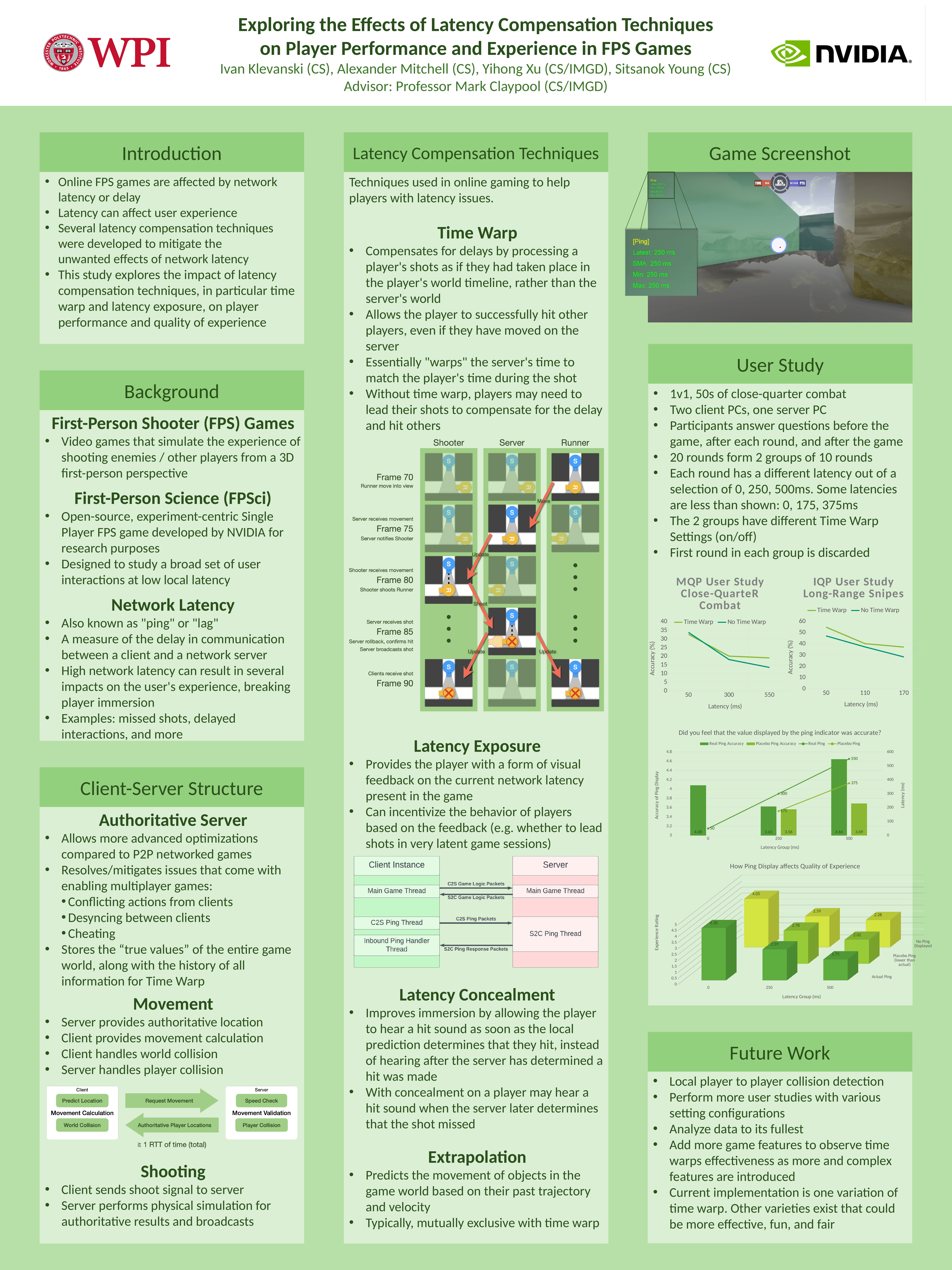
In the 'MQP User Study Close-QuarteR Combat' chart, does accuracy rise or fall as latency increases? fall In the 'IQP User Study Long-Range Snipes' chart, which series has the higher accuracy at 170 ms latency, Time Warp or No Time Warp? Time Warp In the 'MQP User Study Close-QuarteR Combat' chart, is the No Time Warp accuracy at 550 ms latency greater or less than 15? less In the 'MQP User Study Close-QuarteR Combat' chart, how many series does the legend list? 2 In the 'IQP User Study Long-Range Snipes' chart, how many latency values are plotted on the x axis? 3 In the chart titled 'Did you feel that the value displayed by the ping indicator was accurate?', which latency group has the highest Real Ping Accuracy bar? 500 In the 'MQP User Study Close-QuarteR Combat' chart, what are the two legend entries? Time Warp and No Time Warp In the chart titled 'Did you feel that the value displayed by the ping indicator was accurate?', what is the difference between the Real Ping Accuracy and Placebo Ping Accuracy for the 500 ms latency group? 0.95 In the 'IQP User Study Long-Range Snipes' chart, what kind of chart is shown? line chart In the chart titled 'Did you feel that the value displayed by the ping indicator was accurate?', what is the Real Ping Accuracy value for the 0 ms latency group? 4.08 In the 'IQP User Study Long-Range Snipes' chart, is the Time Warp accuracy at 50 ms latency greater or less than 40? greater In the 'How Ping Display affects Quality of Experience' chart, what is the lowest experience rating labelled on any bar? 1.75